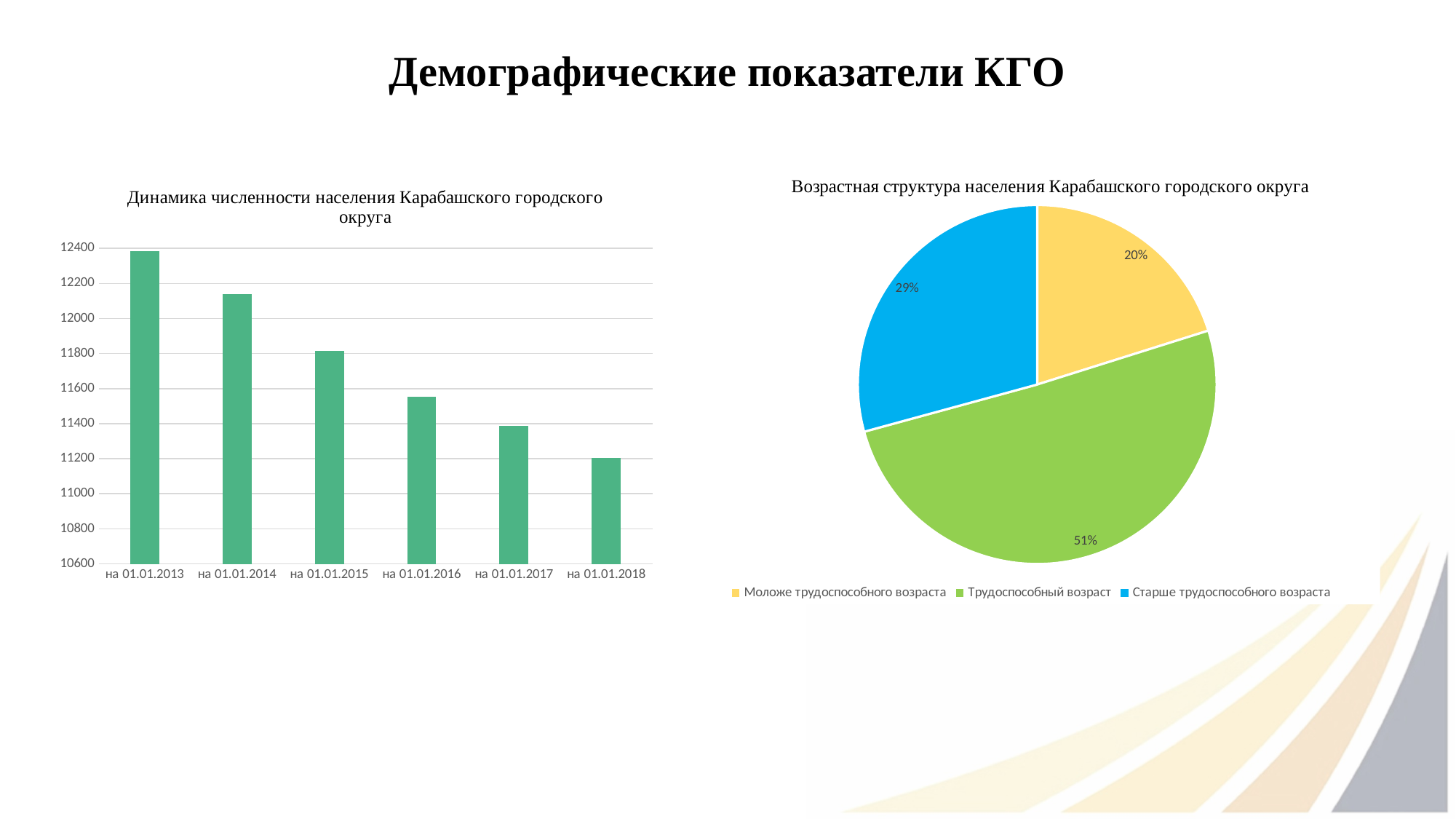
In the left bar chart, which date has the highest population? на 01.01.2013 In the right pie chart, which category has the smallest share? Моложе трудоспособного возраста What kind of chart is the left chart, 'Динамика численности населения Карабашского городского округа'? bar chart In the left bar chart, how many dates are shown on the x axis? 6 In the left bar chart, which date has the lowest population? на 01.01.2018 In the right pie chart, what share is Трудоспособный возраст? 51% In the left bar chart, is the value for на 01.01.2018 greater or less than 11400? less In the left bar chart, do the values rise or fall from 01.01.2013 to 01.01.2018? fall In the right pie chart, what is the difference between the shares of Старше трудоспособного возраста and Моложе трудоспособного возраста? 9% In the left bar chart, is the value for на 01.01.2015 greater or less than 11600? greater What kind of chart is the right chart, 'Возрастная структура населения Карабашского городского округа'? pie chart In the right pie chart, what share is Старше трудоспособного возраста? 29%